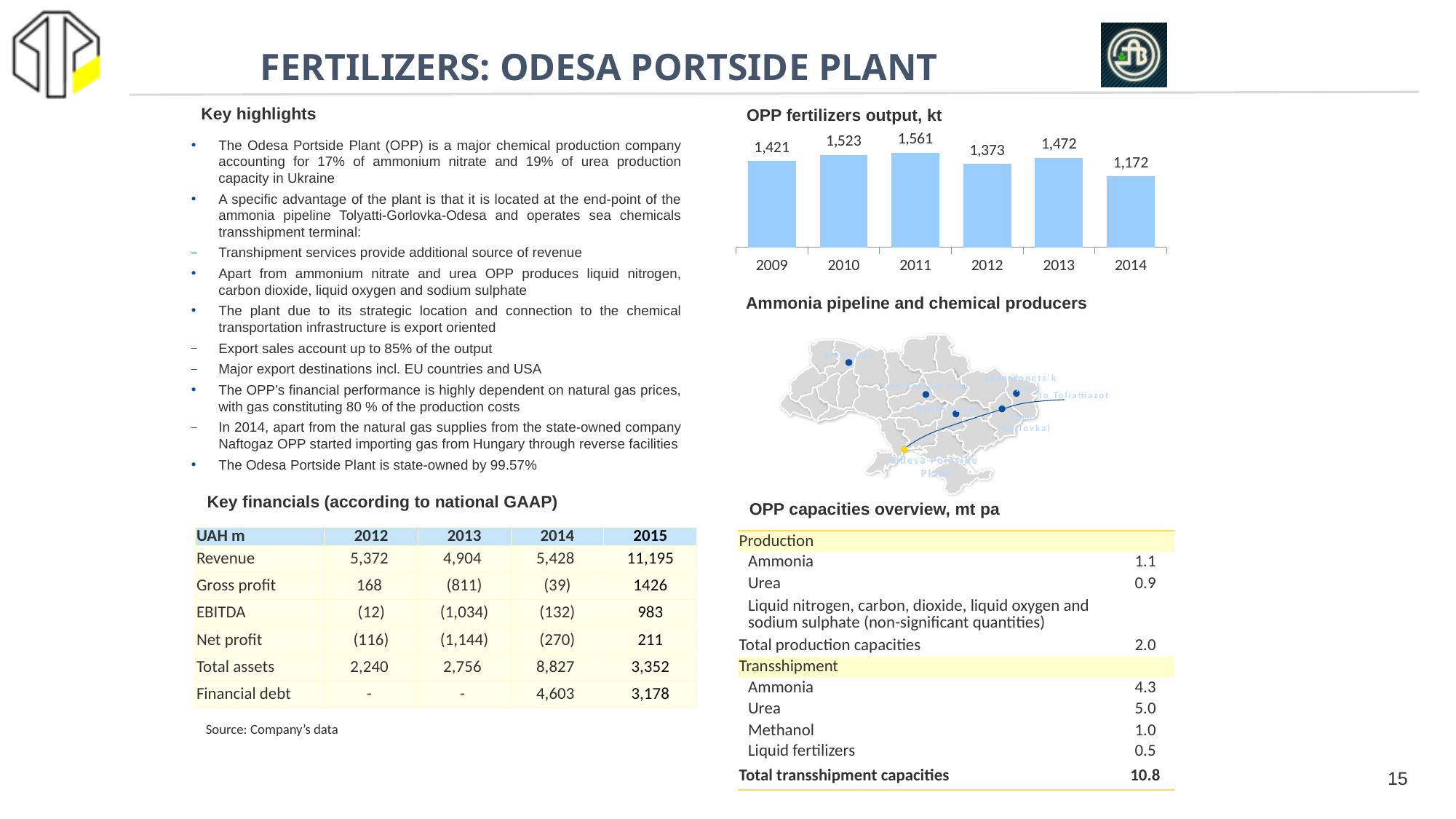
What type of chart is used to show OPP fertilizers output? Bar chart Which year had the lowest OPP fertilizers output? 2014 What is the difference in OPP fertilizers output between 2011 and 2012? 188 What was OPP fertilizers output in 2011? 1,561 How many years are shown in the OPP fertilizers output chart? 6 What was OPP fertilizers output in 2009? 1,421 What is the difference in OPP fertilizers output between 2013 and 2014? 300 In what unit is OPP fertilizers output shown in the chart? kt Did OPP fertilizers output rise or fall from 2013 to 2014? Fall Was OPP fertilizers output higher in 2010 or in 2012? 2010 What was OPP fertilizers output in 2014? 1,172 Which year had the highest OPP fertilizers output? 2011